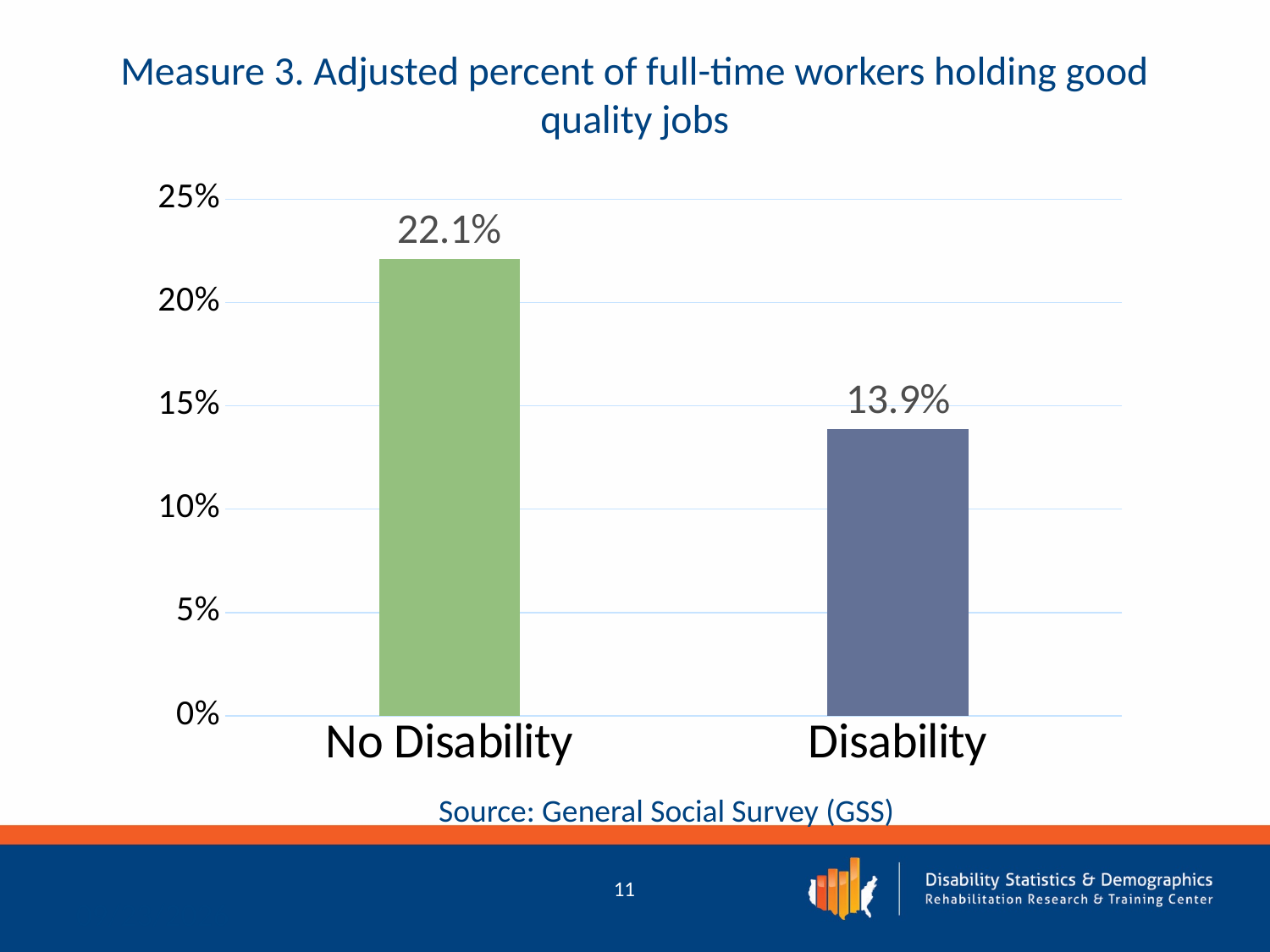
Is the value for Disability greater or less than 15%? less Which category has the highest value? No Disability What is the title of the chart? Measure 3. Adjusted percent of full-time workers holding good quality jobs Is the value for No Disability greater or less than 20%? greater What is the difference between the values for No Disability and Disability? 8.2% Which is larger, the value for No Disability or the value for Disability? No Disability How many categories are shown in the chart? 2 What kind of chart is shown on the slide? bar chart What is the source cited below the chart? General Social Survey (GSS) Which category has the lowest value? Disability What is the value for No Disability? 22.1% What is the value for Disability? 13.9%